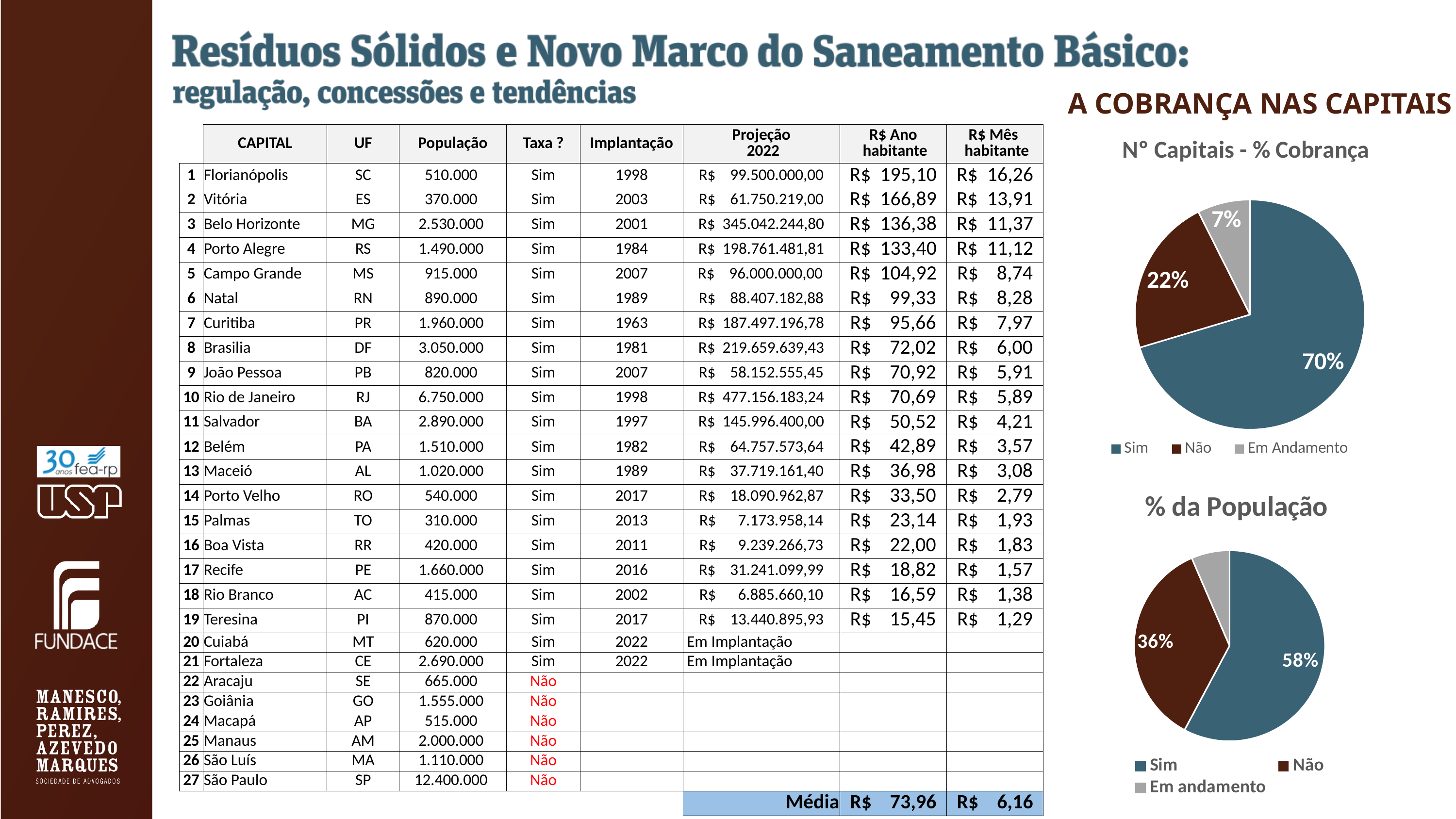
In the 'Nº Capitais - % Cobrança' chart, what share does the 'Não' slice have? 22% In the 'Nº Capitais - % Cobrança' chart, what share does the 'Em Andamento' slice have? 7% In the '% da População' chart, what share does the 'Não' slice have? 36% In the 'Nº Capitais - % Cobrança' chart, what share does the 'Sim' slice have? 70% In the '% da População' chart, which is larger, 'Sim' or 'Não'? Sim In the 'Nº Capitais - % Cobrança' chart, which category has the largest slice? Sim How many categories does the legend of the 'Nº Capitais - % Cobrança' chart list? 3 In the '% da População' chart, which category has the smallest slice? Em andamento What type of chart is the '% da População' chart? Pie chart In the 'Nº Capitais - % Cobrança' chart, which category has the smallest slice? Em Andamento In the '% da População' chart, what share does the 'Sim' slice have? 58% In the 'Nº Capitais - % Cobrança' chart, what is the difference in percentage points between 'Sim' and 'Não'? 48